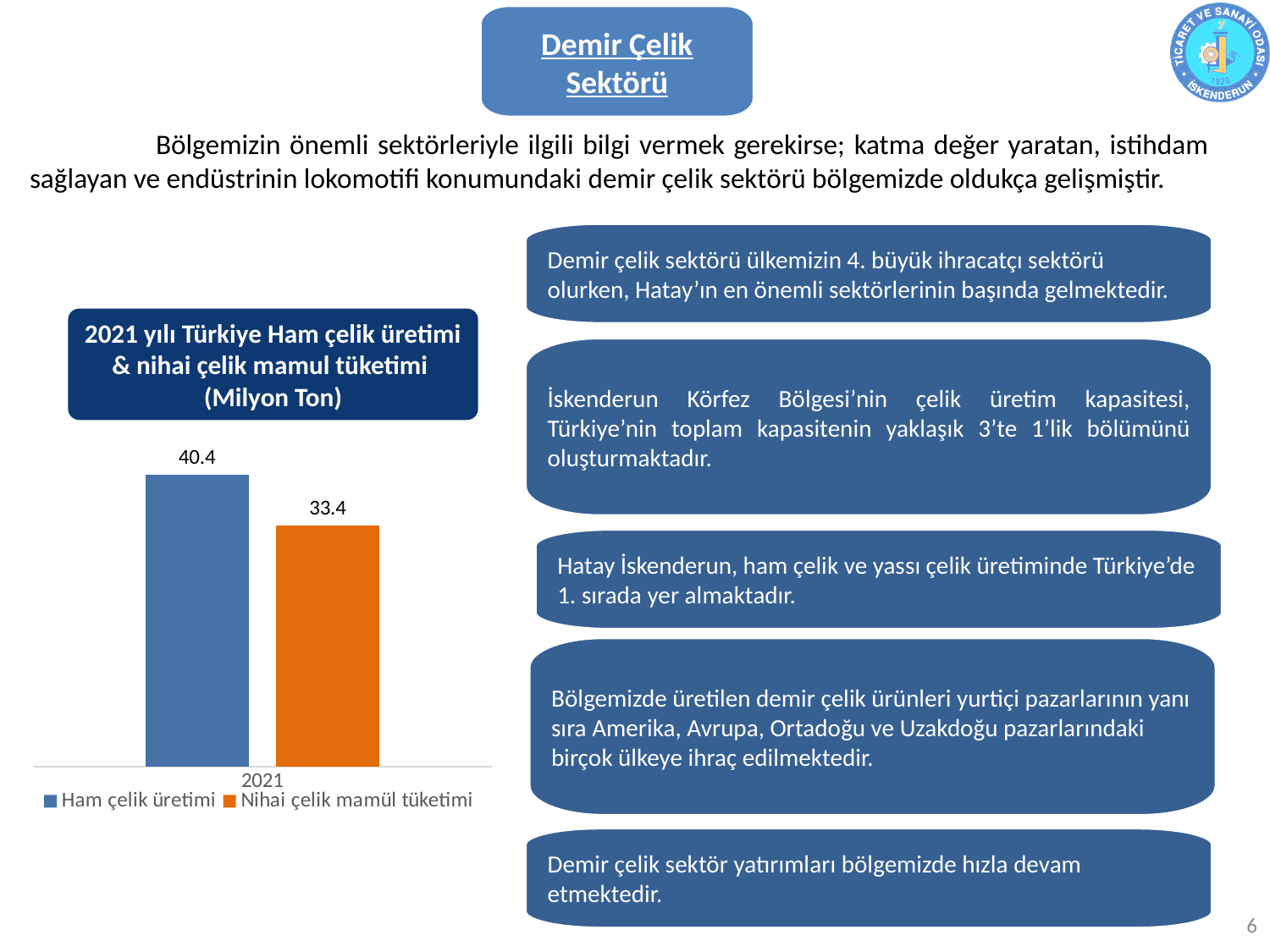
Which series has the higher value in 2021? Ham çelik üretimi What is the title of the chart? 2021 yılı Türkiye Ham çelik üretimi & nihai çelik mamul tüketimi (Milyon Ton) Which series has the lower value in 2021? Nihai çelik mamül tüketimi What unit are the chart values given in? Milyon Ton What colour is the bar for Nihai çelik mamül tüketimi? orange What kind of chart is shown on the slide? bar chart What is the value for Ham çelik üretimi in 2021? 40.4 How many series does the legend list? 2 Is the value for Ham çelik üretimi larger or smaller than the value for Nihai çelik mamül tüketimi? larger What is the value for Nihai çelik mamül tüketimi in 2021? 33.4 How many categories are shown on the x axis? 1 What is the difference between Ham çelik üretimi and Nihai çelik mamül tüketimi in 2021? 7.0